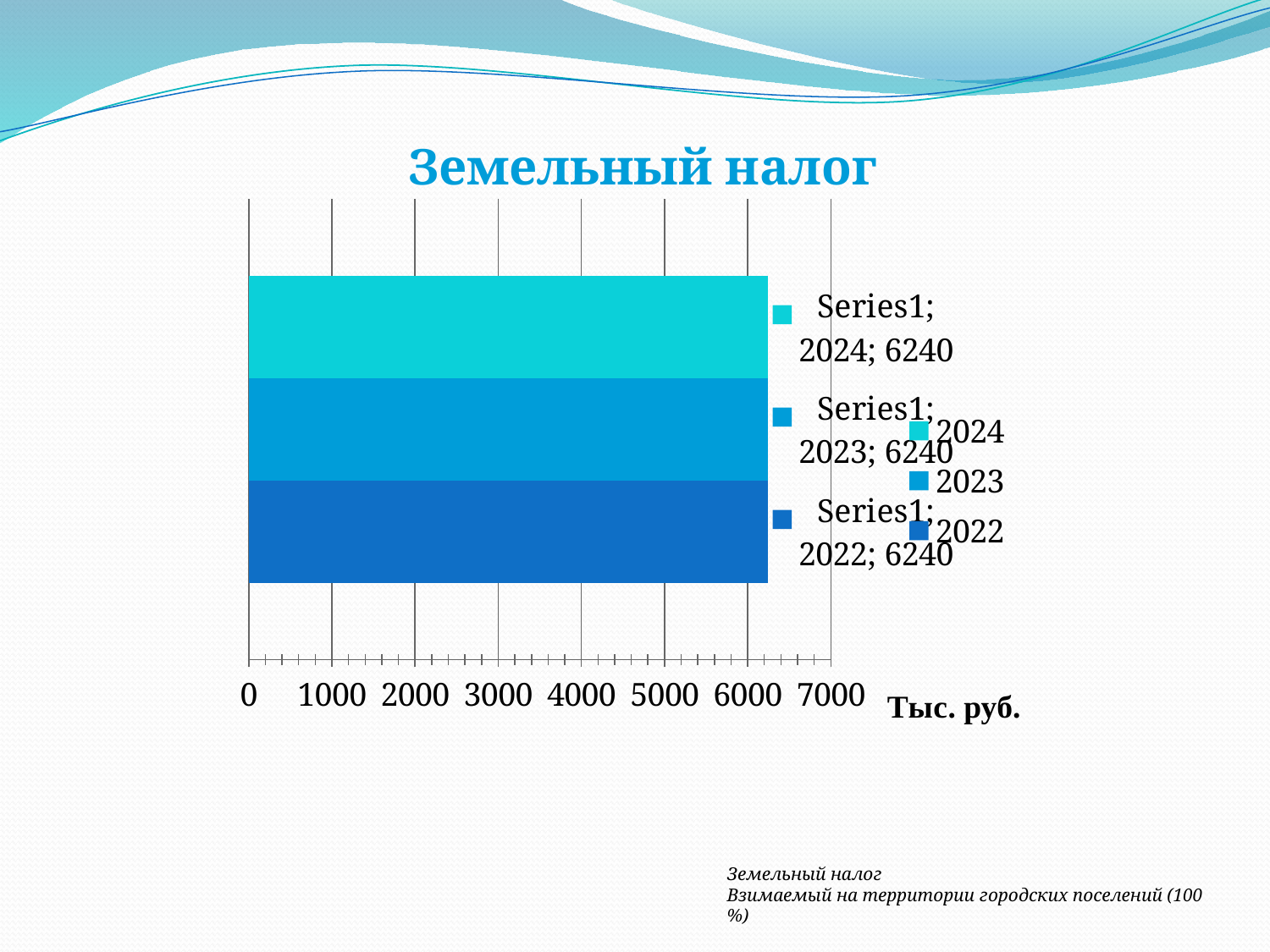
Do the values change from 2022 to 2024? No, they stay the same How many bars are plotted in the chart? 3 What is the value for 2022 in the Земельный налог chart? 6240 What is the value for 2024 in the Земельный налог chart? 6240 What is the difference between the values for 2024 and 2022? 0 Is the value for 2022 greater or less than 7000? less What is the title of the chart? Земельный налог How many entries does the legend list? 3 What is the value for 2023 in the Земельный налог chart? 6240 What unit is shown on the value axis label? Тыс. руб. What kind of chart is shown on the slide? bar chart Is the value for 2023 greater or less than 6000? greater